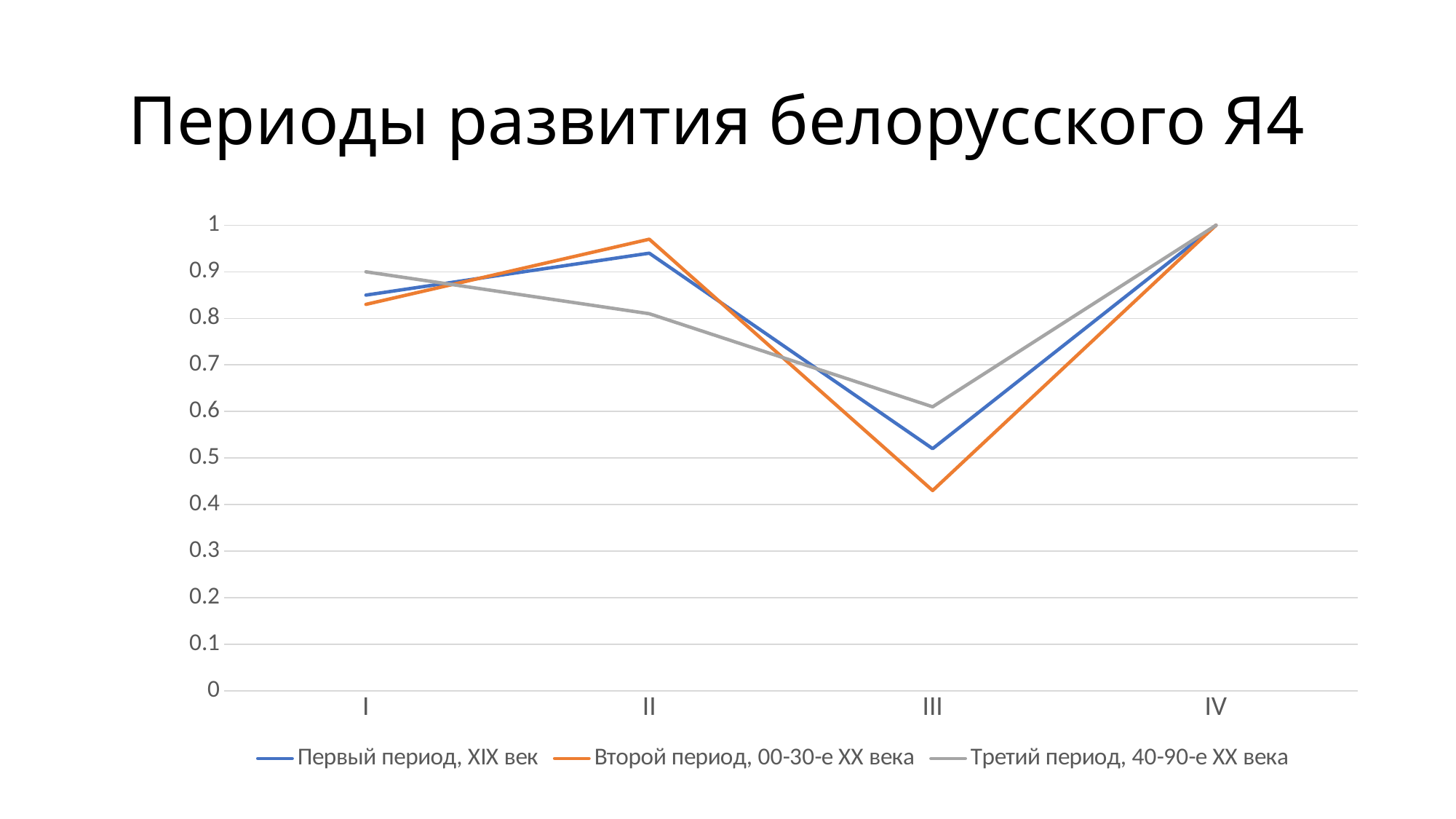
Is the value for "Второй период, 00-30-е XX века" at category III greater or less than 0.5? less How many categories are on the x axis? 4 What is the title of the slide? Периоды развития белорусского Я4 What is the value of the series "Первый период, XIX век" at category IV? 1 At which category does the series "Третий период, 40-90-е XX века" reach its highest value? IV What kind of chart is shown on the slide? line chart At which category does the series "Второй период, 00-30-е XX века" reach its lowest value? III Do the values of all three series rise or fall from category III to category IV? rise How many series does the legend list? 3 At category III, which series has the larger value: "Третий период, 40-90-е XX века" or "Второй период, 00-30-е XX века"? Третий период, 40-90-е XX века What is the value of the series "Третий период, 40-90-е XX века" at category IV? 1 Is the value for "Второй период, 00-30-е XX века" at category II greater or less than 0.9? greater